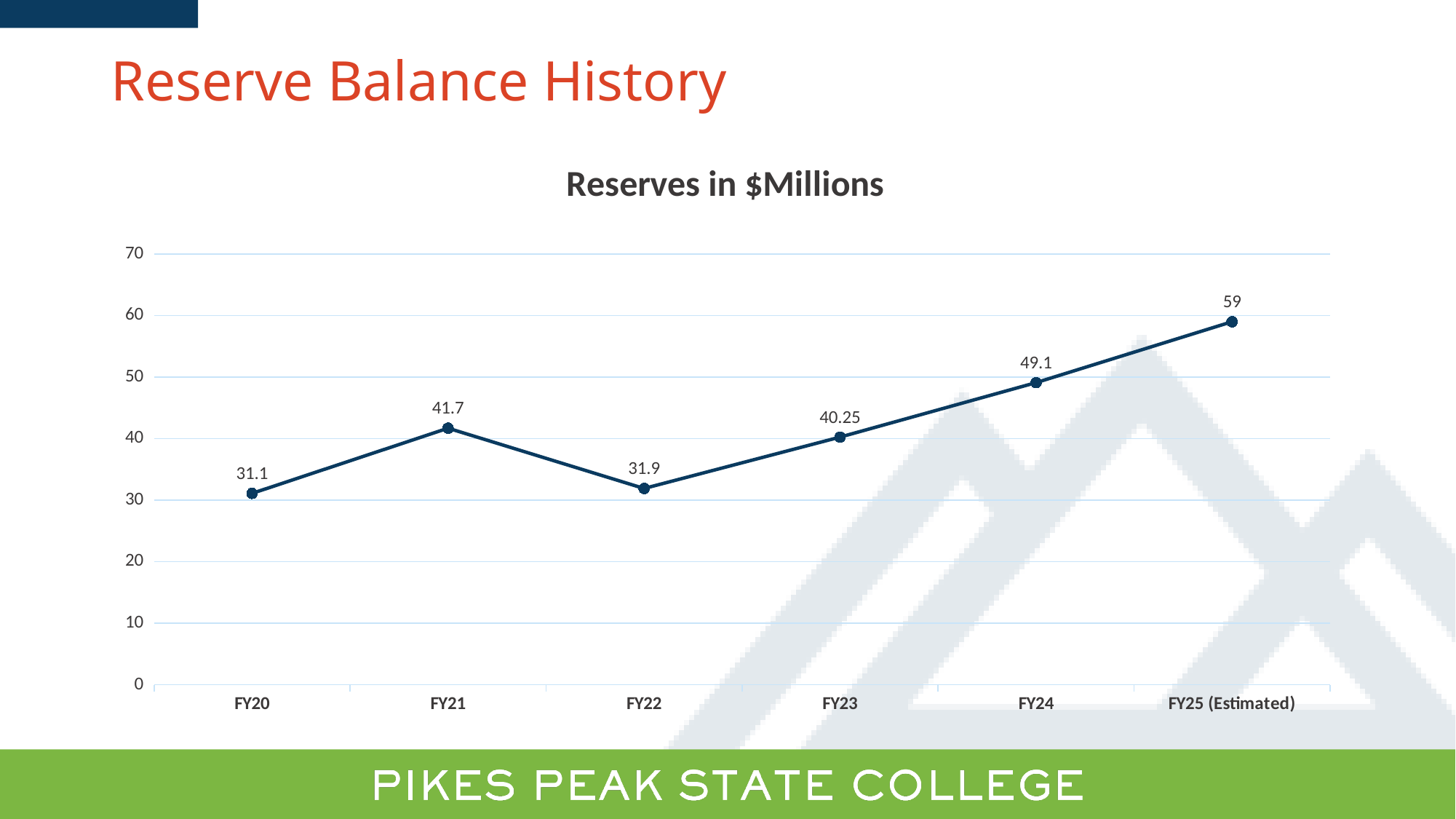
What kind of chart is shown on the slide? line chart Which fiscal year has the lowest reserve value? FY20 What is the reserve value for FY23? 40.25 What is the estimated reserve value for FY25? 59 Which fiscal year has the highest reserve value? FY25 (Estimated) How many fiscal years are plotted on the chart? 6 What is the reserve value for FY21? 41.7 Is the reserve value for FY24 greater or less than 40? greater What is the difference between the FY24 and FY23 reserve values? 8.85 Do the reserve values rise or fall from FY22 to FY25 (Estimated)? rise Which is larger, the reserve value for FY21 or FY22? FY21 What is the title of the chart? Reserves in $Millions